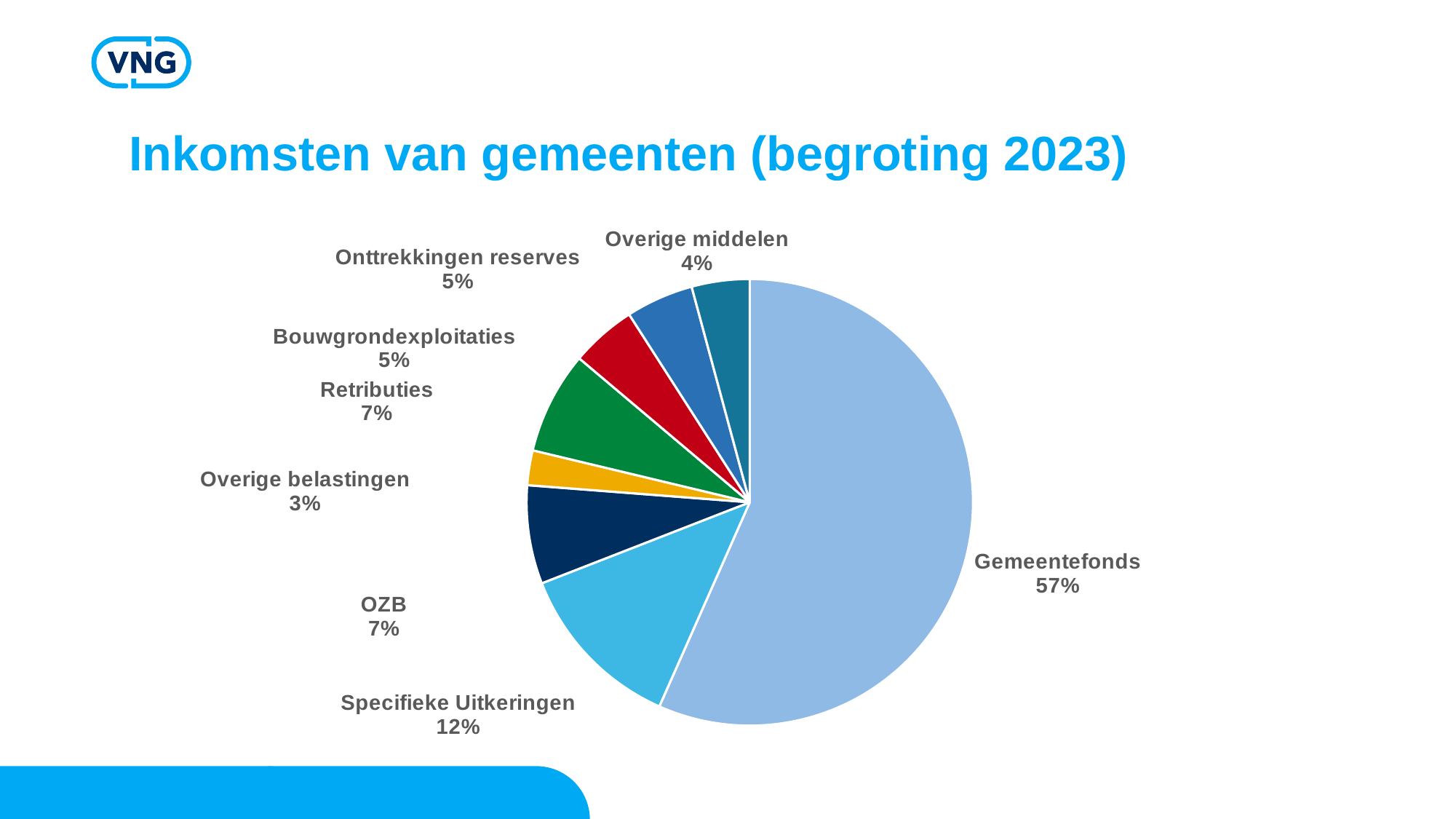
What is the value shown for Overige belastingen? 3% What is the title of the slide containing the pie chart? Inkomsten van gemeenten (begroting 2023) Which category has the smallest slice of the pie? Overige belastingen What is the combined share of OZB and Overige belastingen? 10% How many categories (slices) does the pie chart have? 8 What is the value shown for Specifieke Uitkeringen? 12% What is the difference between the shares of Gemeentefonds and Specifieke Uitkeringen? 45% What share of the pie does Gemeentefonds represent? 57% Which category has the largest slice of the pie? Gemeentefonds What is the value shown for Overige middelen? 4% What kind of chart is shown on the slide? pie chart Which is larger, the share for Retributies or the share for Bouwgrondexploitaties? Retributies